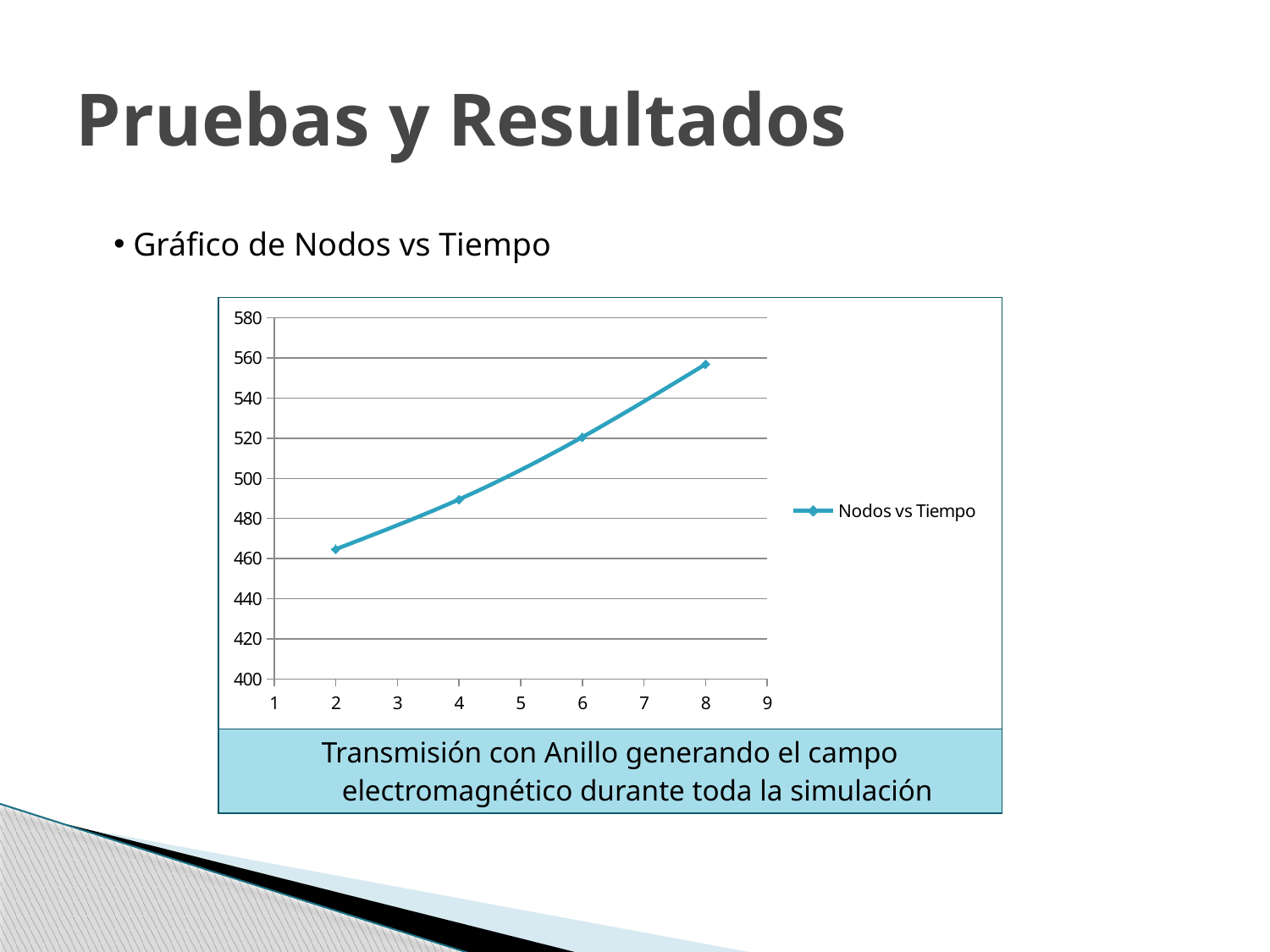
What is the name of the series shown in the legend? Nodos vs Tiempo Do the values rise or fall as the x axis increases from 2 to 8? rise Is the value at x = 4 greater or less than 480? greater At which x value is the plotted value lowest? 2 What caption appears in the box below the chart? Transmisión con Anillo generando el campo electromagnético durante toda la simulación At which x value is the plotted value highest? 8 How many data points are plotted on the Nodos vs Tiempo line? 4 Is the value at x = 2 greater or less than 480? less Is the value at x = 8 greater or less than 540? greater How many series does the legend list? 1 What kind of chart is shown on the slide? line chart Which is larger, the value at x = 4 or the value at x = 6? x = 6